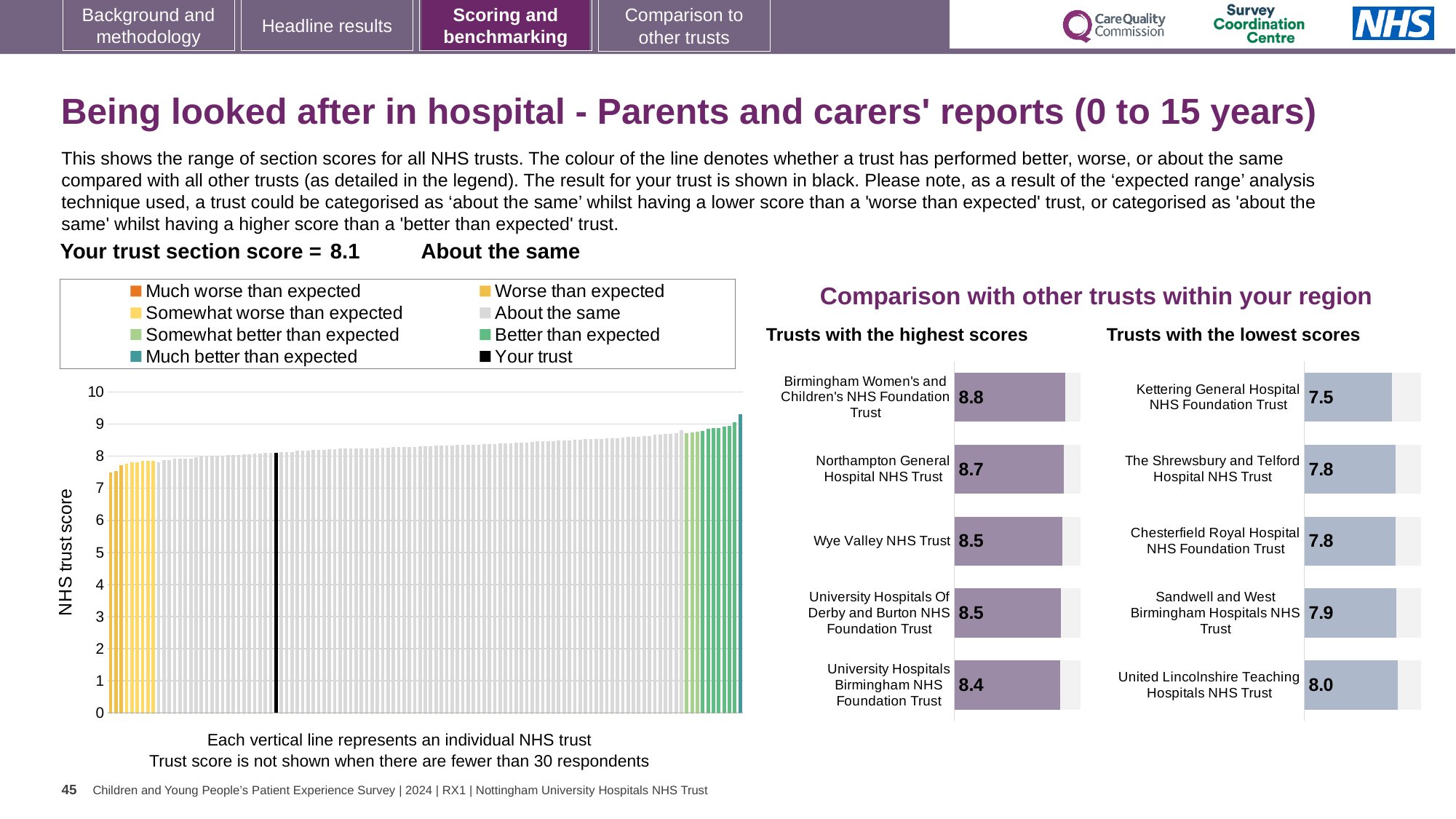
In the 'Trusts with the lowest scores' chart, what is the score for Kettering General Hospital NHS Foundation Trust? 7.5 How many entries does the legend above the large chart on the left list? 8 In the 'Trusts with the highest scores' chart, which trust has the highest score? Birmingham Women's and Children's NHS Foundation Trust What kind of chart is the large chart on the left showing the range of section scores for all NHS trusts? Bar chart In the 'Trusts with the lowest scores' chart, which has the larger score: Kettering General Hospital NHS Foundation Trust or Sandwell and West Birmingham Hospitals NHS Trust? Sandwell and West Birmingham Hospitals NHS Trust In the 'Trusts with the lowest scores' chart, which trust has the lowest score? Kettering General Hospital NHS Foundation Trust In the 'Trusts with the highest scores' chart, what is the difference between the scores of Birmingham Women's and Children's NHS Foundation Trust and University Hospitals Birmingham NHS Foundation Trust? 0.4 What is the section score for your trust shown on the slide? 8.1 In the 'Trusts with the highest scores' chart, how many trusts are listed? 5 In the 'Trusts with the highest scores' chart, what is the score for Northampton General Hospital NHS Trust? 8.7 On the large chart on the left, what is the label on the vertical axis? NHS trust score In the 'Trusts with the lowest scores' chart, what is the difference between the scores of United Lincolnshire Teaching Hospitals NHS Trust and Kettering General Hospital NHS Foundation Trust? 0.5